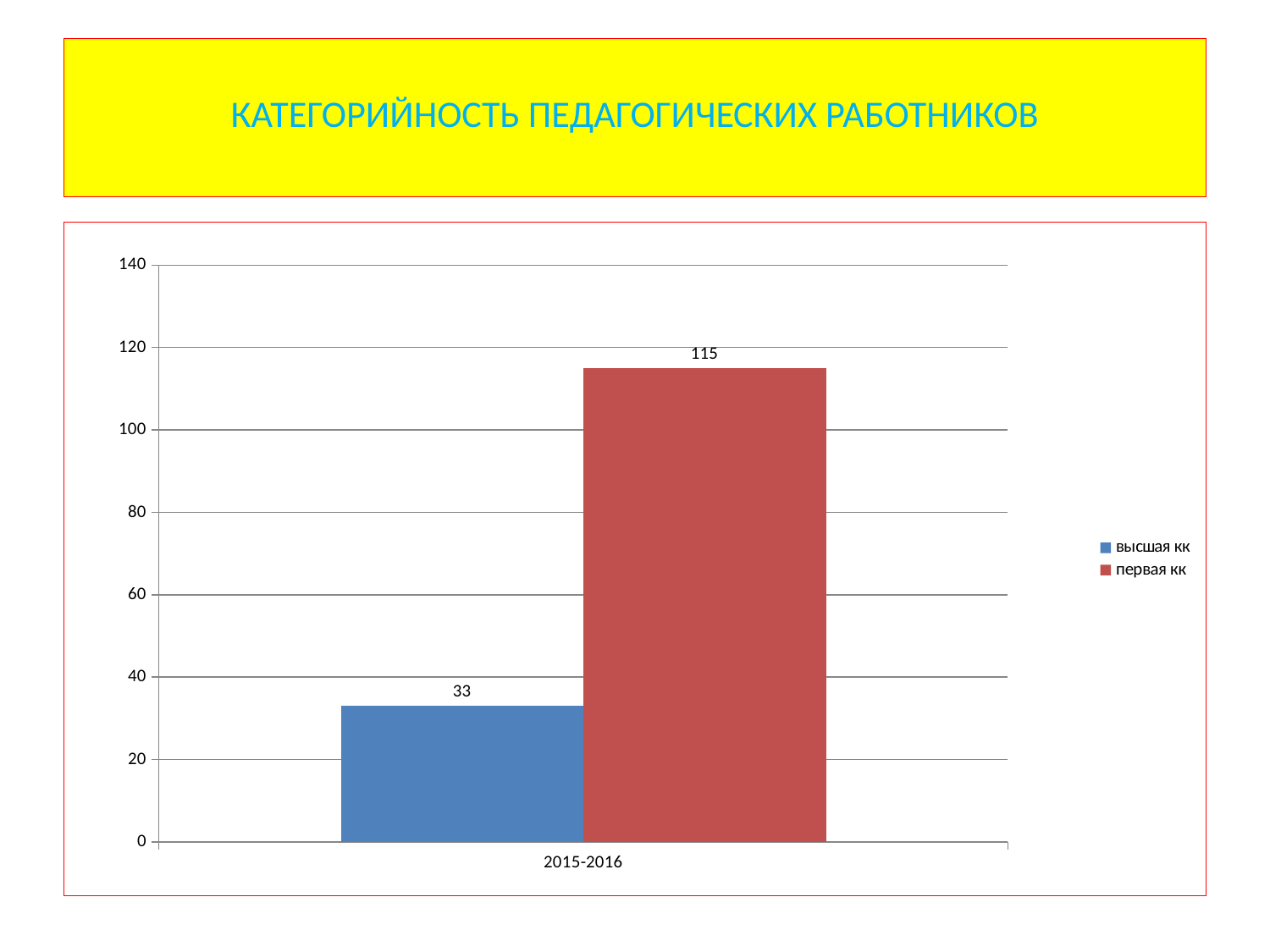
How many series does the legend list? 2 Is the value for высшая кк greater or less than 40? less Which series has the higher value in 2015-2016? первая кк What is the value for высшая кк in 2015-2016? 33 How many categories are shown on the x axis? 1 What is the value for первая кк in 2015-2016? 115 What is the difference between the values for первая кк and высшая кк? 82 Which series has the lower value in 2015-2016? высшая кк Is the value for первая кк larger or smaller than the value for высшая кк? larger Is the value for первая кк greater or less than 100? greater What is the title of the slide? КАТЕГОРИЙНОСТЬ ПЕДАГОГИЧЕСКИХ РАБОТНИКОВ What kind of chart is shown on the slide? bar chart